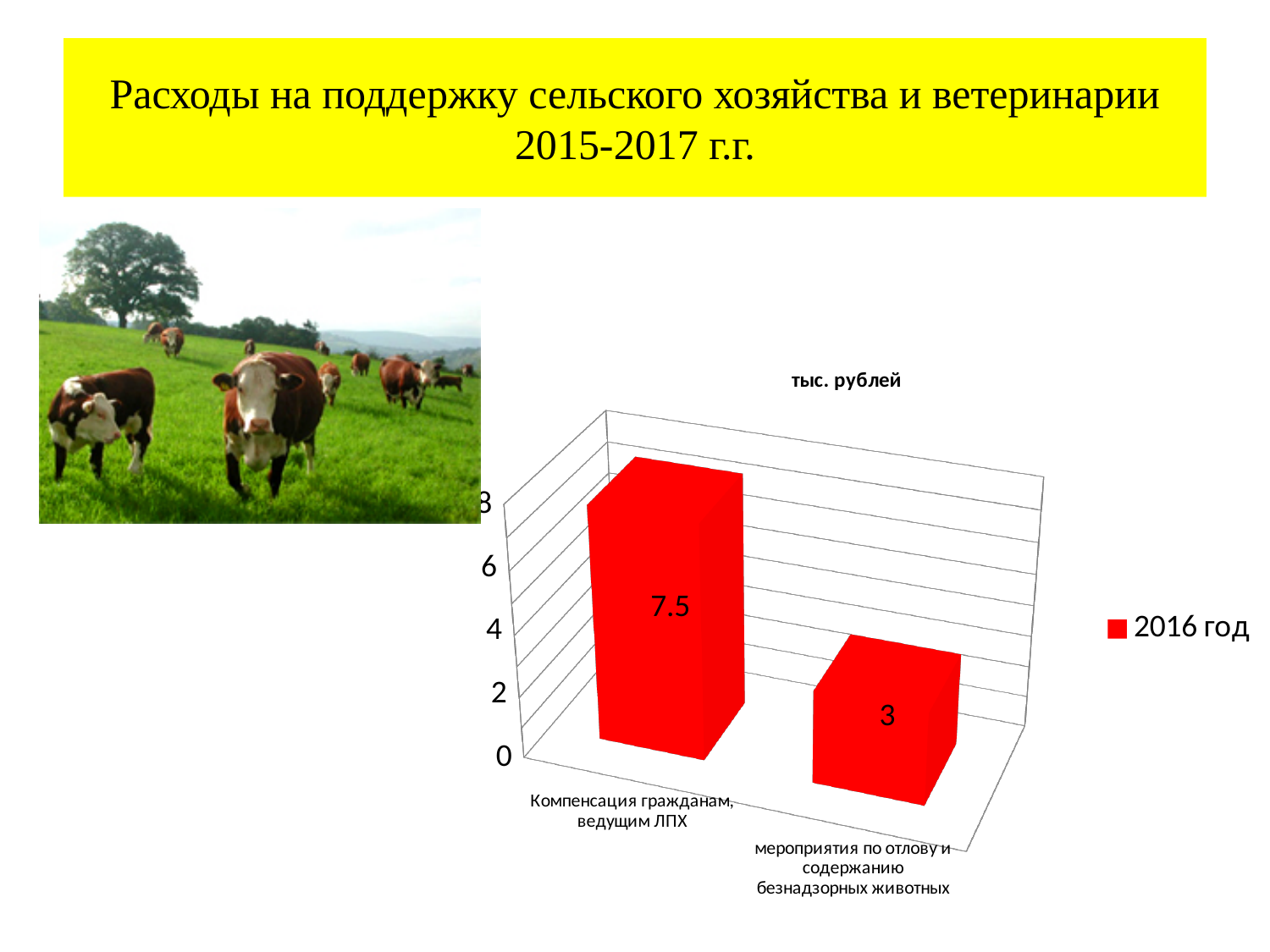
Is the value for "Компенсация гражданам, ведущим ЛПХ" greater or less than 6? greater Is the value for "мероприятия по отлову и содержанию безнадзорных животных" greater or less than 4? less Which category has the lowest value? мероприятия по отлову и содержанию безнадзорных животных What is the difference between the value for "Компенсация гражданам, ведущим ЛПХ" and the value for "мероприятия по отлову и содержанию безнадзорных животных"? 4.5 Which category has the highest value? Компенсация гражданам, ведущим ЛПХ Which is larger: the value for "Компенсация гражданам, ведущим ЛПХ" or the value for "мероприятия по отлову и содержанию безнадзорных животных"? Компенсация гражданам, ведущим ЛПХ What series name is shown in the chart legend? 2016 год What is the value for "Компенсация гражданам, ведущим ЛПХ"? 7.5 What is the value for "мероприятия по отлову и содержанию безнадзорных животных"? 3 How many series does the legend list? 1 How many categories are shown in the chart? 2 What kind of chart is shown on the slide? bar chart